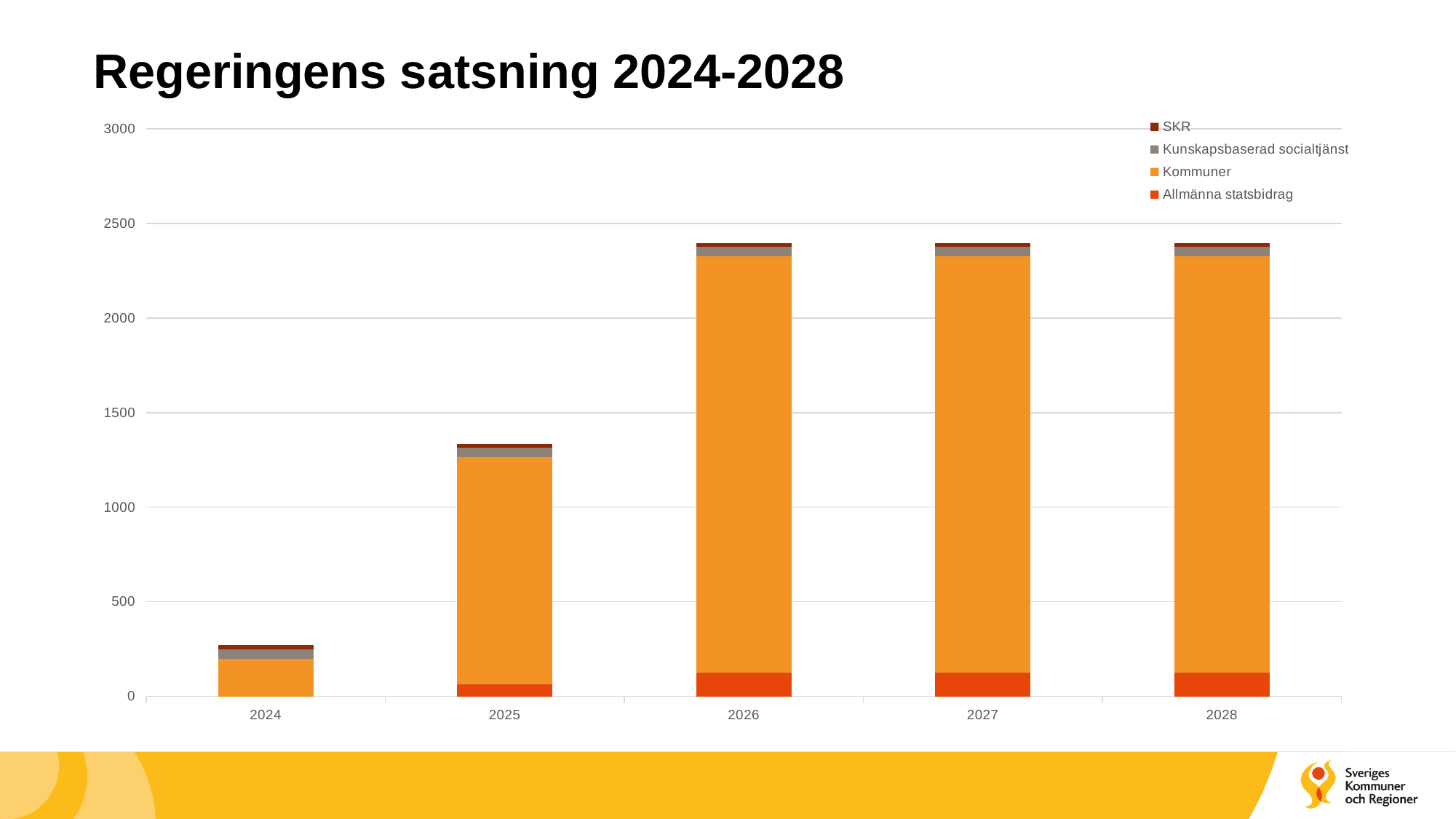
Is the total bar for 2025 greater or less than 1500? less Which year has the lowest total bar? 2024 Is the total bar for 2027 greater or less than 2000? greater Which year has the larger total bar, 2025 or 2026? 2026 Is the total bar for 2025 greater or less than 1000? greater What kind of chart is shown on the slide? Stacked bar chart How many series does the legend list? 4 What is the title of the chart? Regeringens satsning 2024-2028 How many years are shown on the x axis? 5 Do the total bars rise or fall from 2024 to 2026? rise